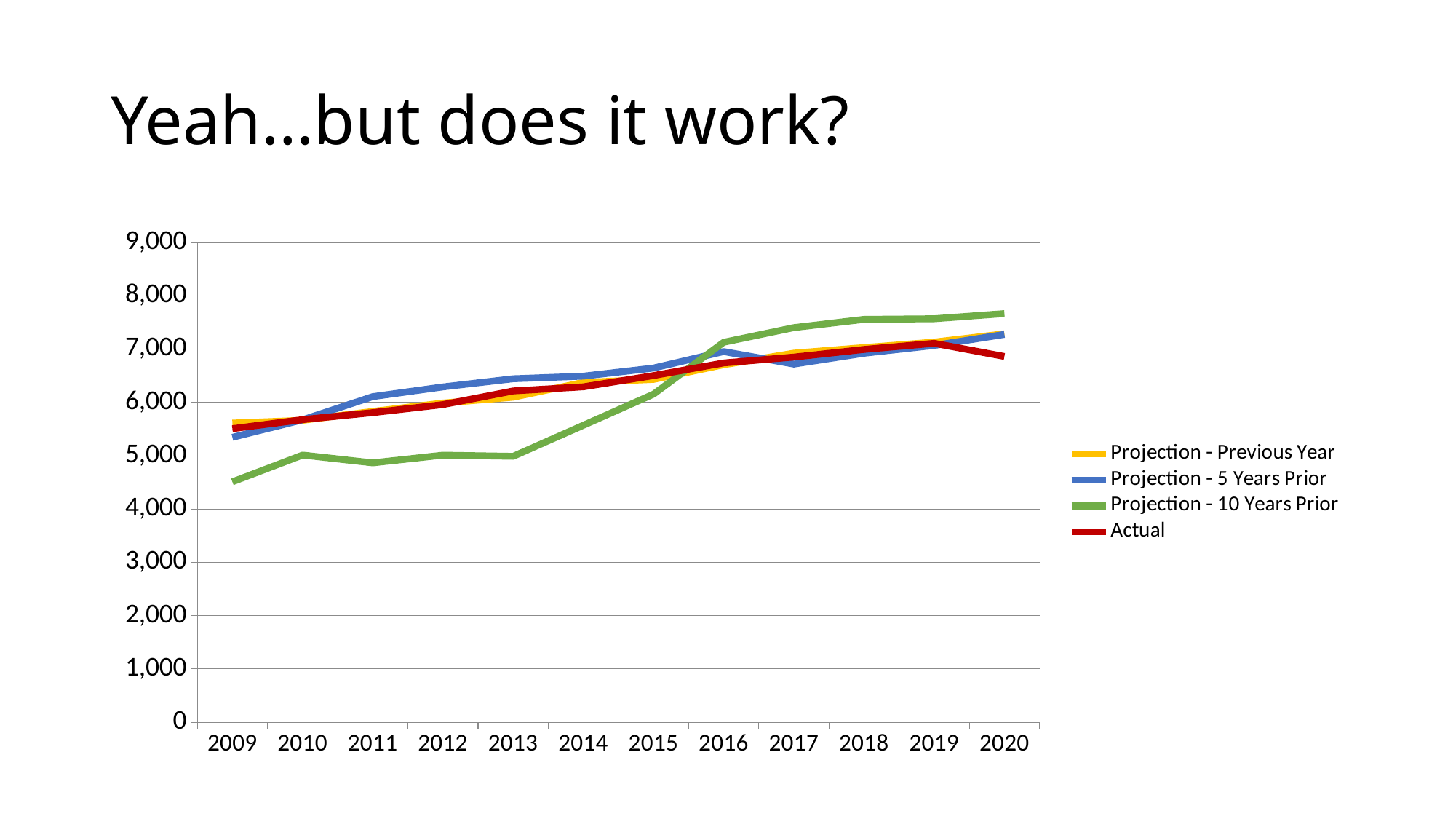
What colour is the Actual line in the legend? red Which series has the highest value in 2020? Projection - 10 Years Prior Which series has the lowest value in 2009? Projection - 10 Years Prior How many series does the legend list? 4 In 2013, is Projection - 10 Years Prior higher or lower than Actual? lower Does the Projection - 10 Years Prior line generally rise or fall from 2009 to 2020? rise Is the value for Actual in 2020 greater or less than 6,000? greater Is the value for Projection - 5 Years Prior in 2013 greater or less than 6,000? greater Is the value for Projection - 10 Years Prior in 2009 greater or less than 5,000? less How many years are shown along the x axis? 12 What kind of chart is shown on the slide? line chart